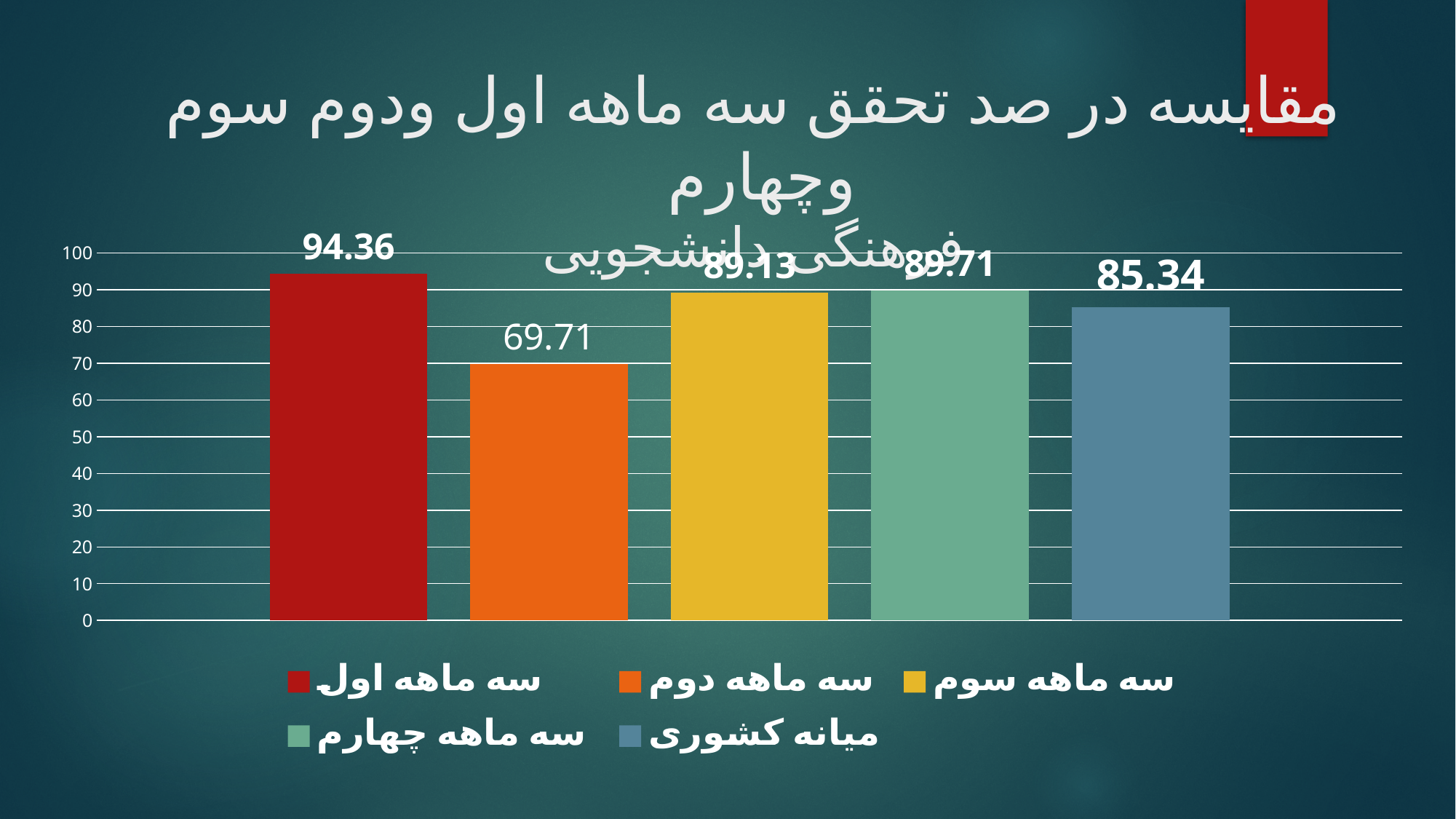
How many bars are plotted in the chart? 5 What is the value shown for سه ماهه دوم? 69.71 Which category has the highest value? سه ماهه اول What is the value shown for سه ماهه اول? 94.36 What is the difference between the values for سه ماهه اول and میانه کشوری? 9.02 What is the difference between the values for سه ماهه اول and سه ماهه دوم? 24.65 How many entries does the legend list? 5 Is the value for میانه کشوری greater or less than 80? greater Which category has the lowest value? سه ماهه دوم What kind of chart is shown on the slide? bar chart Which is larger, the value for سه ماهه اول or the value for میانه کشوری? سه ماهه اول What is the value shown for میانه کشوری? 85.34